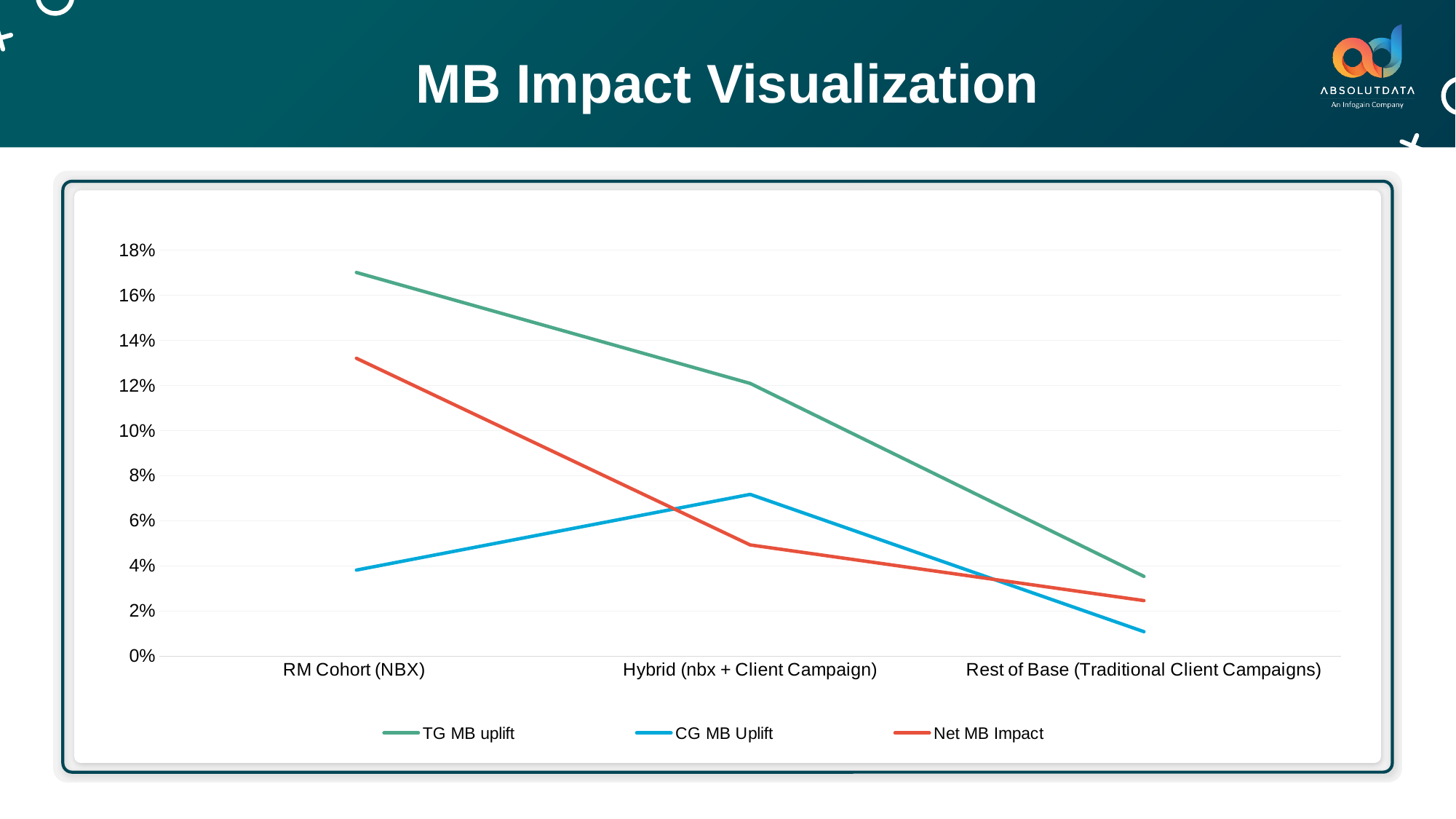
Is the Net MB Impact value for RM Cohort (NBX) greater or less than 12%? greater How many series does the legend list? 3 For which category is Net MB Impact lowest? Rest of Base (Traditional Client Campaigns) For which category is CG MB Uplift highest? Hybrid (nbx + Client Campaign) For which category is TG MB uplift highest? RM Cohort (NBX) Is the TG MB uplift value for RM Cohort (NBX) greater or less than 16%? greater Does TG MB uplift rise or fall from RM Cohort (NBX) to Rest of Base (Traditional Client Campaigns)? fall Is the CG MB Uplift value for Rest of Base (Traditional Client Campaigns) greater or less than 2%? less How many categories are shown on the x axis? 3 What is the title of the slide containing the chart? MB Impact Visualization What kind of chart is shown on the slide? line chart At Hybrid (nbx + Client Campaign), which is larger: CG MB Uplift or Net MB Impact? CG MB Uplift